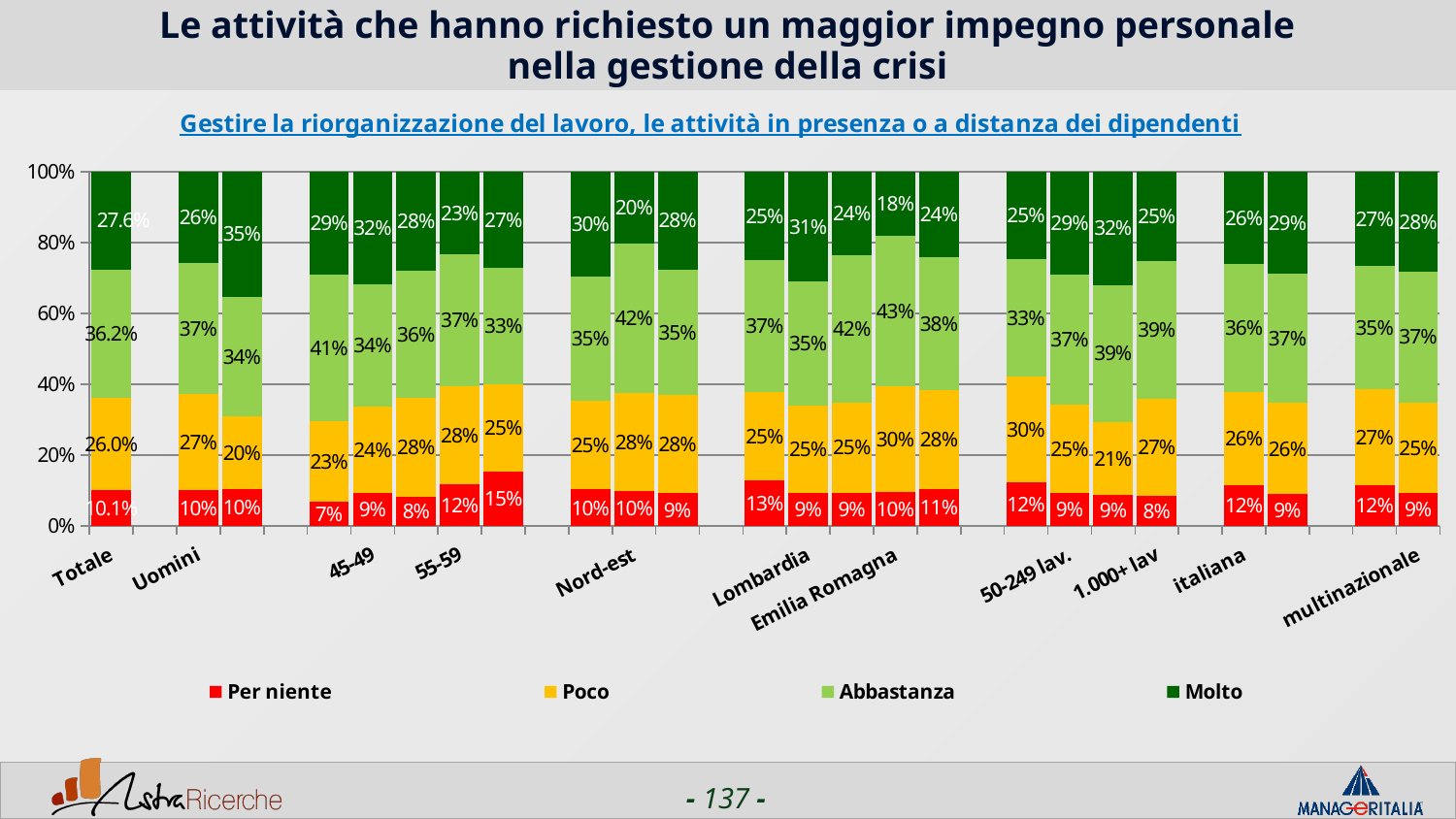
What is the 'Abbastanza' value for Totale? 36.2% What is the 'Molto' value for Totale? 27.6% What is the 'Abbastanza' value for italiana? 36% What are the four series listed in the legend? Per niente, Poco, Abbastanza, Molto For Totale, which is larger: the 'Abbastanza' share or the 'Molto' share? Abbastanza What is the 'Per niente' value for italiana? 12% Which colour represents the 'Per niente' series? red What is the 'Per niente' value for Totale? 10.1% How many series does the legend list? 4 For Totale, what is the difference between the 'Abbastanza' value and the 'Poco' value? 10.2% What type of chart is shown on the slide? stacked bar chart What is the 'Poco' value for Totale? 26.0%